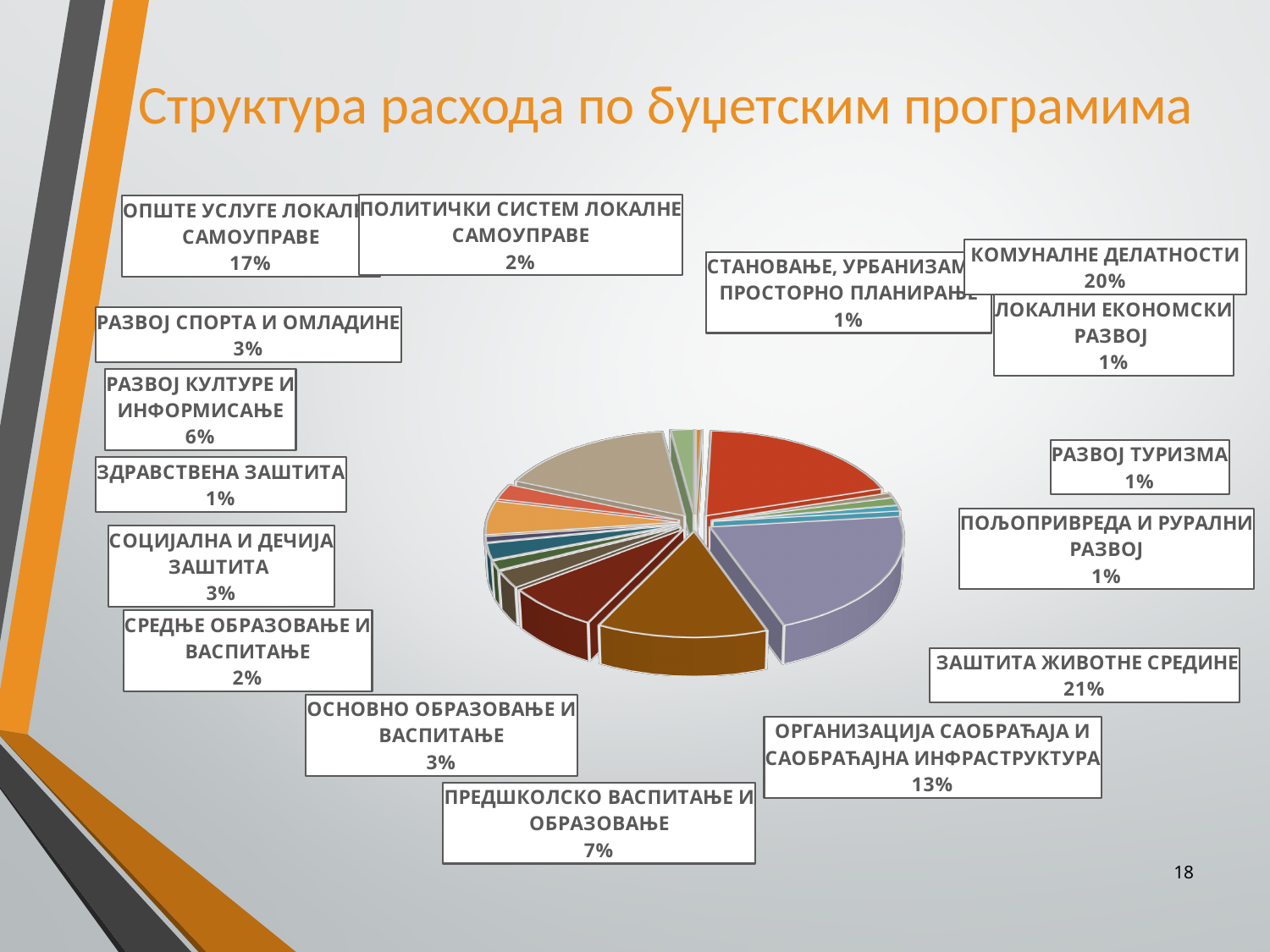
What percentage is shown for РАЗВОЈ КУЛТУРЕ И ИНФОРМИСАЊЕ? 6% What is the difference in percentage points between ЗАШТИТА ЖИВОТНЕ СРЕДИНЕ and ПРЕДШКОЛСКО ВАСПИТАЊЕ И ОБРАЗОВАЊЕ? 14 What is the title of the chart on the slide? Структура расхода по буџетским програмима What percentage is shown for РАЗВОЈ ТУРИЗМА? 1% What share of expenditure goes to КОМУНАЛНЕ ДЕЛАТНОСТИ? 20% What percentage is shown for ОРГАНИЗАЦИЈА САОБРАЋАЈА И САОБРАЋАЈНА ИНФРАСТРУКТУРА? 13% Which is larger, the share for КОМУНАЛНЕ ДЕЛАТНОСТИ or the share for ОРГАНИЗАЦИЈА САОБРАЋАЈА И САОБРАЋАЈНА ИНФРАСТРУКТУРА? КОМУНАЛНЕ ДЕЛАТНОСТИ Which budget programme has the largest share of expenditure? ЗАШТИТА ЖИВОТНЕ СРЕДИНЕ What percentage is shown for ПРЕДШКОЛСКО ВАСПИТАЊЕ И ОБРАЗОВАЊЕ? 7% What share of expenditure goes to ЗАШТИТА ЖИВОТНЕ СРЕДИНЕ? 21% What is the difference in percentage points between КОМУНАЛНЕ ДЕЛАТНОСТИ and РАЗВОЈ КУЛТУРЕ И ИНФОРМИСАЊЕ? 14 What type of chart is shown on the slide? pie chart